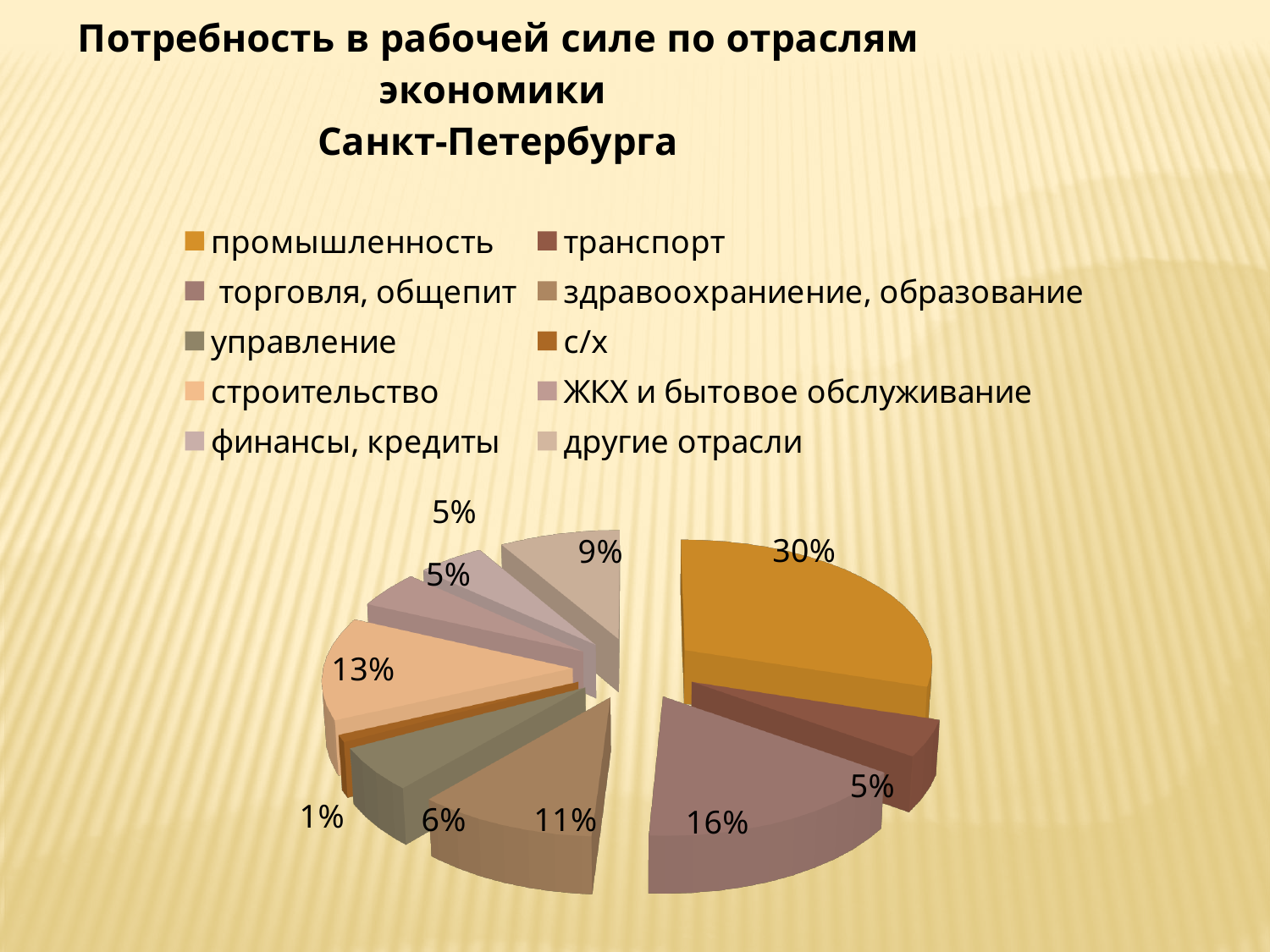
What share of the pie does здравоохраниение, образование have? 11% What is the difference in percentage points between промышленность and торговля, общепит? 14 Which category has the largest slice of the pie? промышленность What share of the pie does управление have? 6% What share of the pie does промышленность have? 30% How many categories does the legend of the pie chart list? 10 What is the title of the chart on the slide? Потребность в рабочей силе по отраслям экономики Санкт-Петербурга What kind of chart is shown on the slide? pie chart Which is larger, the share for строительство or the share for другие отрасли? строительство Which category has the smallest slice of the pie? с/х